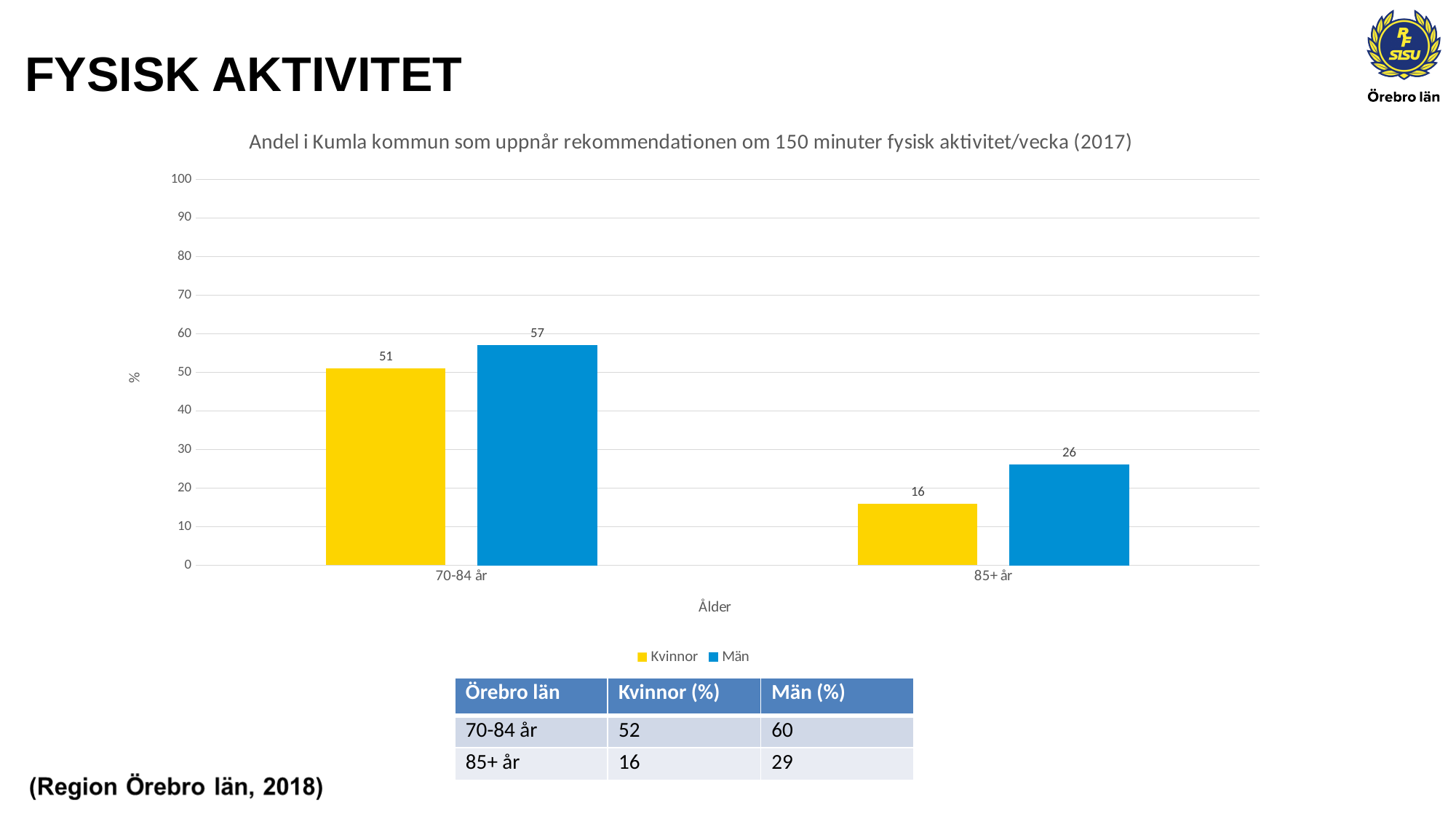
What is the value for Män in the 85+ år age group? 26 What is the value for Kvinnor in the 70-84 år age group? 51 Which bar has the lowest value in the chart? Kvinnor, 85+ år Which colour represents Kvinnor in the chart? Yellow Which is larger, the value for Kvinnor in 70-84 år or the value for Män in 85+ år? Kvinnor in 70-84 år Which bar has the highest value in the chart? Män, 70-84 år How many age groups are shown on the x axis? 2 What is the value for Män in the 70-84 år age group? 57 What is the difference between Män and Kvinnor in the 85+ år age group? 10 What kind of chart is shown on the slide? Bar chart How many series does the legend list? 2 What is the difference between Män and Kvinnor in the 70-84 år age group? 6